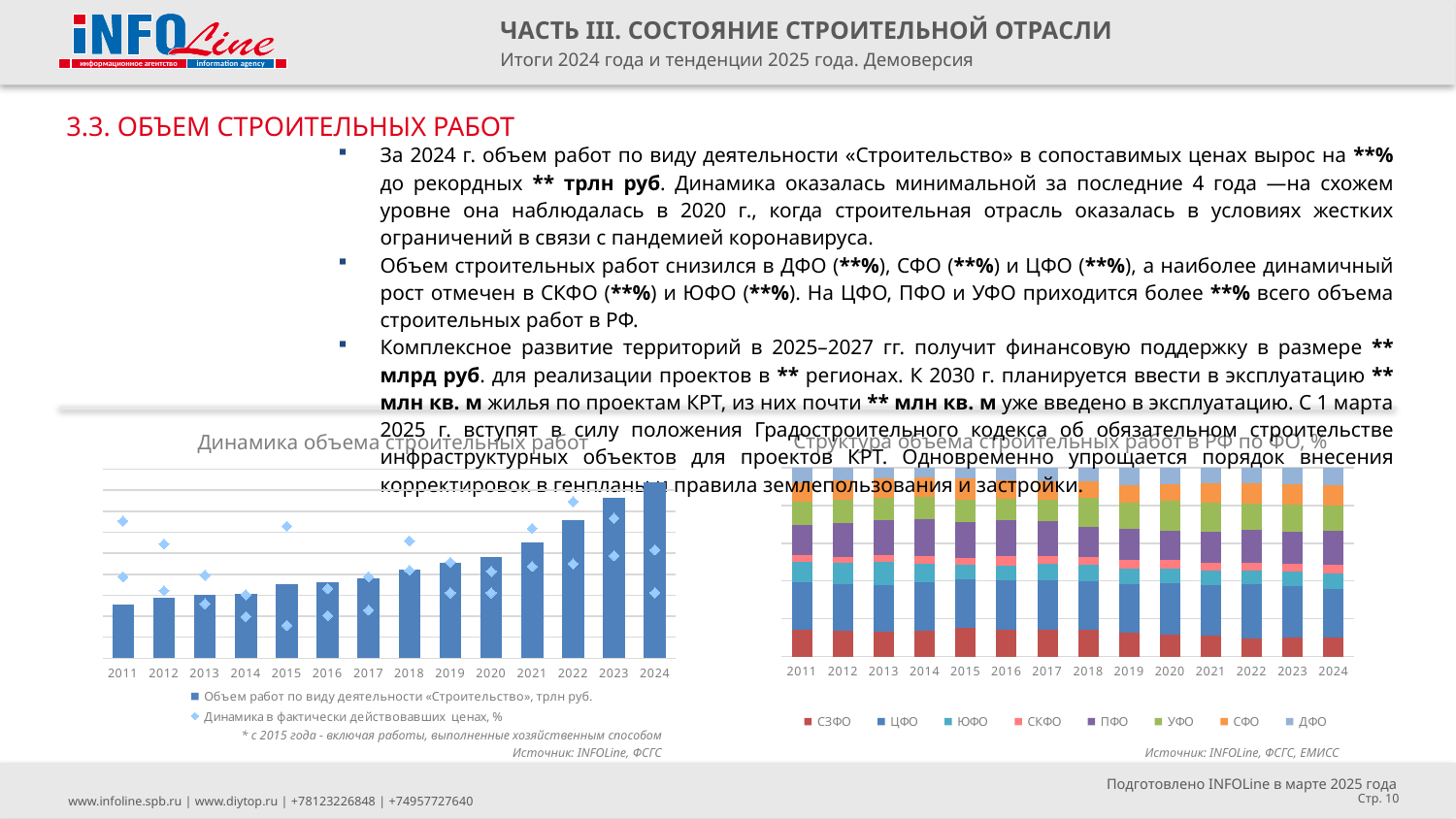
In the right chart «Структура объема строительных работ в РФ по ФО, %», how many series does the legend list? 8 What kind of chart is the right chart titled «Структура объема строительных работ в РФ по ФО, %»? stacked bar chart What kind of chart is the left chart titled «Динамика объема строительных работ»? combination bar and line chart (bars with diamond markers) In the right chart «Структура объема строительных работ в РФ по ФО, %», which federal district has the largest segment in the 2024 bar? ЦФО What is the source cited under the right chart «Структура объема строительных работ в РФ по ФО, %»? INFOLine, ФСГС, ЕМИСС In the left chart «Динамика объема строительных работ», how many years are shown on the x axis? 14 In the left chart «Динамика объема строительных работ», is the bar for 2023 taller or shorter than the bar for 2018? taller In the left chart «Динамика объема строительных работ», do the bars for «Объем работ по виду деятельности «Строительство», трлн руб.» generally rise or fall from 2011 to 2024? rise In the left chart «Динамика объема строительных работ», how many series does the legend list? 2 In the left chart «Динамика объема строительных работ», which year has the shortest bar for «Объем работ по виду деятельности «Строительство», трлн руб.»? 2011 In the left chart «Динамика объема строительных работ», which year has the tallest bar for «Объем работ по виду деятельности «Строительство», трлн руб.»? 2024 In the right chart «Структура объема строительных работ в РФ по ФО, %», which series is listed first in the legend? СЗФО